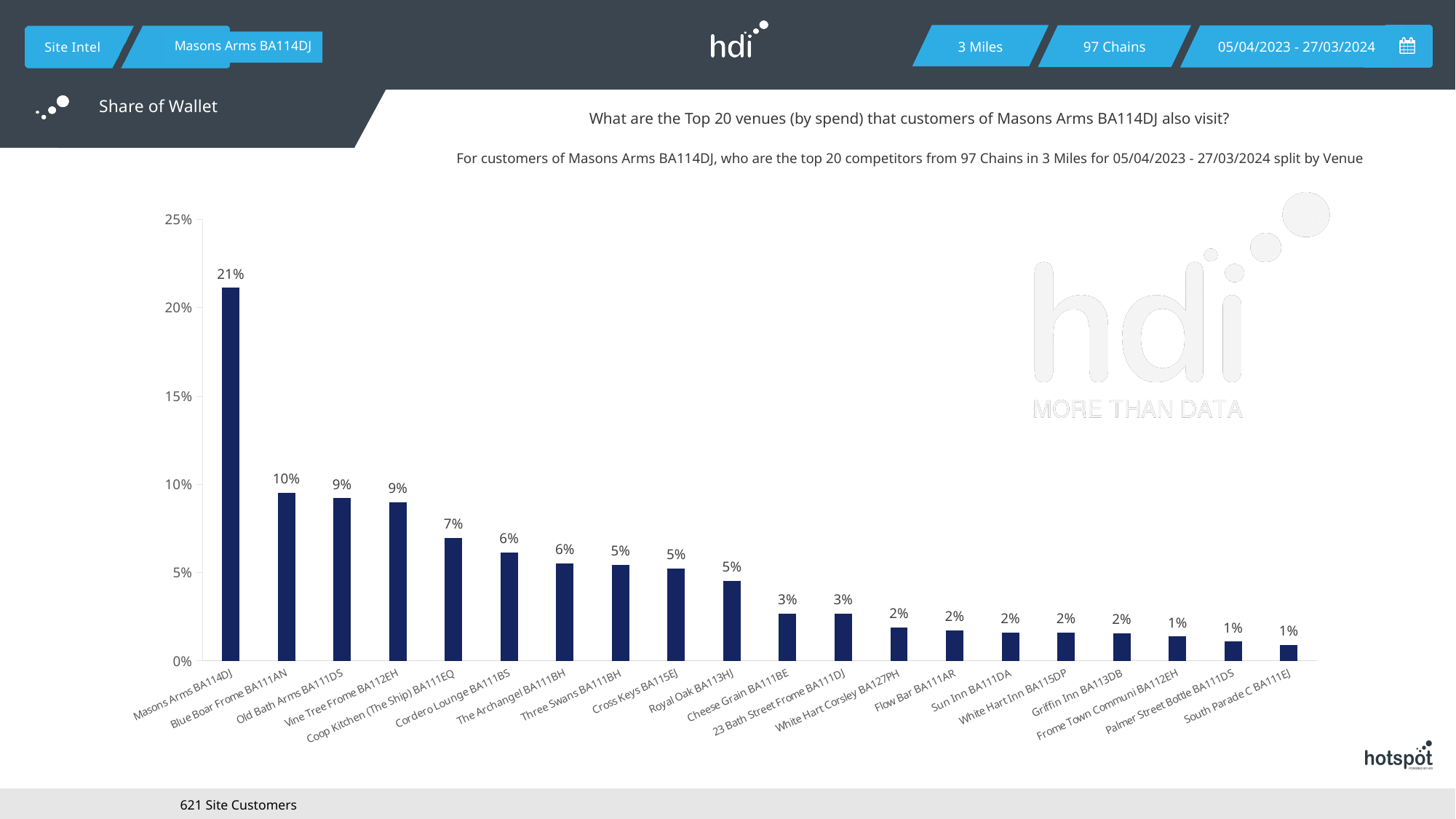
Which venue has the highest value? Masons Arms BA114DJ Which is larger, the value for Cordero Lounge BA111BS or the value for Cheese Grain BA111BE? Cordero Lounge BA111BS Do the values rise or fall from left to right along the x axis? Fall What is the value for Cheese Grain BA111BE? 3% What is the difference between the values for Masons Arms BA114DJ and Blue Boar Frome BA111AN? 11% What is the value for Masons Arms BA114DJ? 21% How many venues are shown on the chart? 20 What is the value for Coop Kitchen (The Ship) BA111EQ? 7% What is the value for Blue Boar Frome BA111AN? 10% What kind of chart is shown on the slide? Bar chart Is the value for Coop Kitchen (The Ship) BA111EQ greater or less than 10%? less Is the value for Masons Arms BA114DJ greater or less than 20%? greater